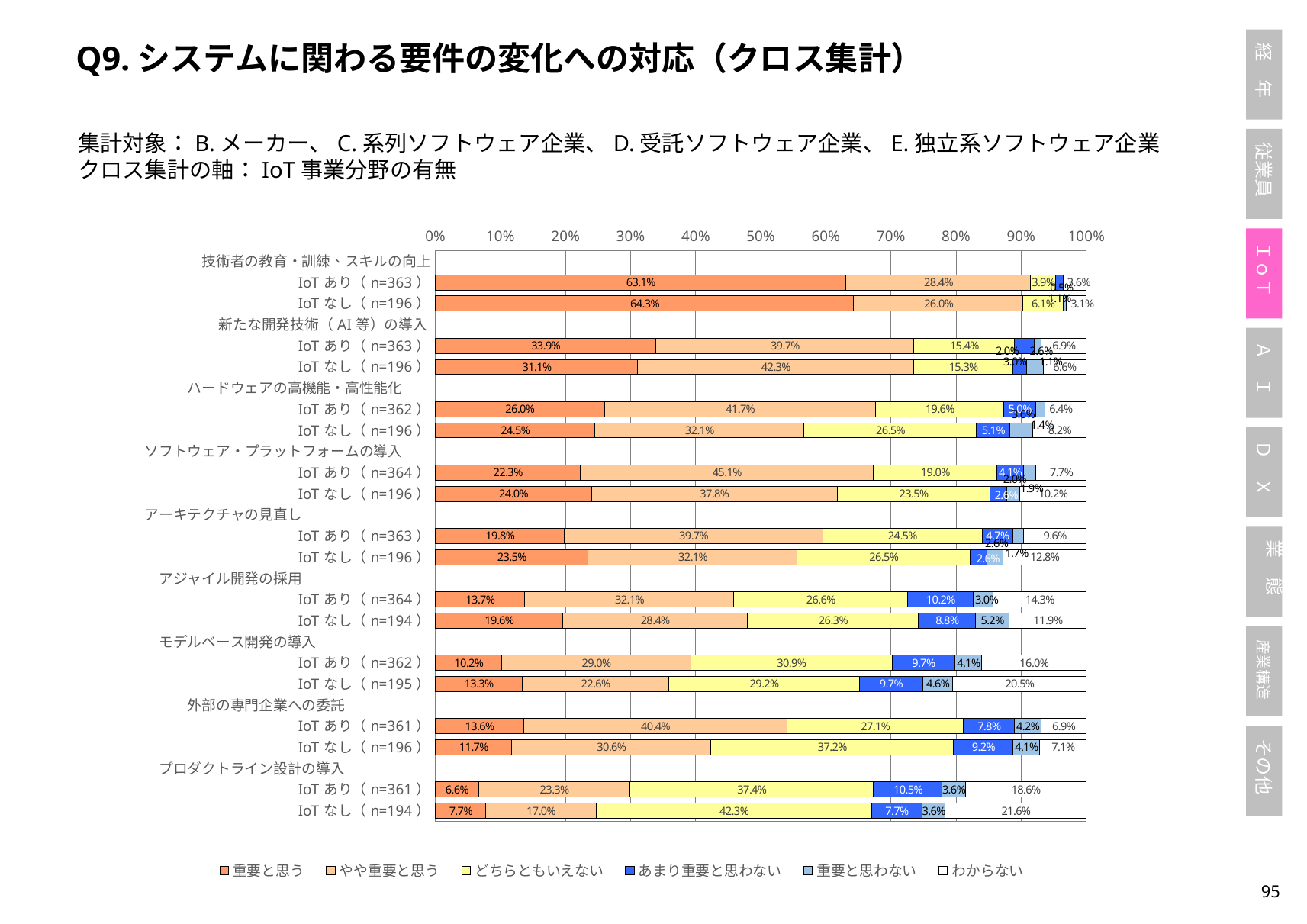
Which bar has the lowest 重要と思う value? プロダクトライン設計の導入 IoT あり (n=361) What is the 重要と思う value for 技術者の教育・訓練、スキルの向上 IoT あり (n=363)? 63.1% What is the わからない value for モデルベース開発の導入 IoT なし (n=195)? 20.5% What is the やや重要と思う value for 新たな開発技術（AI 等）の導入 IoT なし (n=196)? 42.3% Which bar has the highest 重要と思う value? 技術者の教育・訓練、スキルの向上 IoT なし (n=196) What is the difference between the 重要と思う values for アジャイル開発の採用 IoT なし (n=194) and IoT あり (n=364)? 5.9% What kind of chart is shown on the slide? Stacked bar chart How many series does the legend list? 6 What is the first entry in the legend? 重要と思う Is the 重要と思う value for ハードウェアの高機能・高性能化 IoT あり (n=362) greater or less than 20%? greater What is the あまり重要と思わない value for アジャイル開発の採用 IoT あり (n=364)? 10.2% Which is larger: the どちらともいえない value for 外部の専門企業への委託 IoT あり (n=361) or IoT なし (n=196)? IoT なし (n=196)